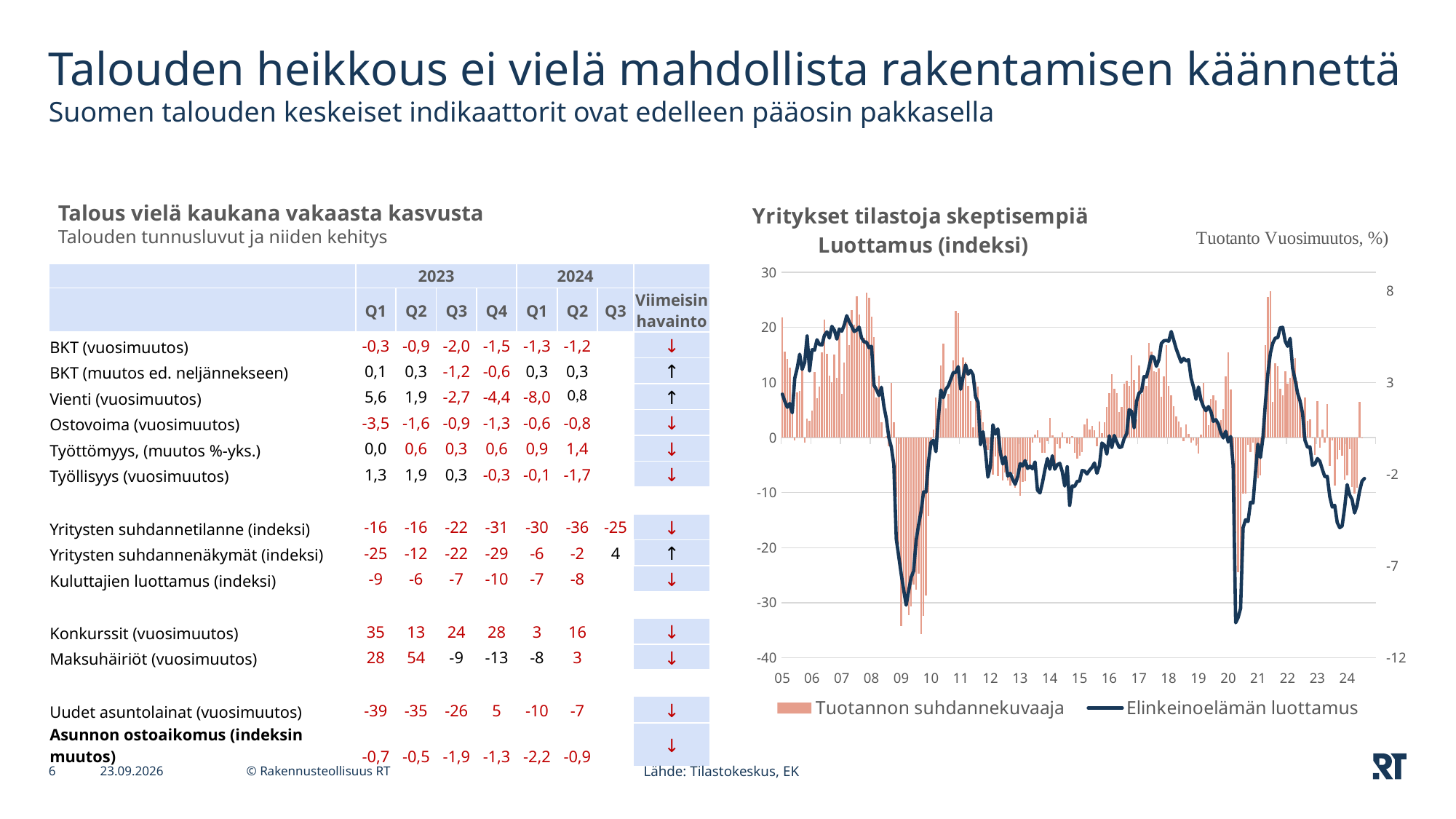
How many series does the legend of the chart "Yritykset tilastoja skeptisempiä" list? 2 In the chart "Yritykset tilastoja skeptisempiä", is the value of Elinkeinoelämän luottamus at the end of 2024 greater or less than 0? less How many year labels are shown on the x axis of the chart "Yritykset tilastoja skeptisempiä"? 20 What kind of chart is shown on the right side of the slide under the title "Yritykset tilastoja skeptisempiä"? A combined bar and line chart In the chart "Yritykset tilastoja skeptisempiä", is the value of Elinkeinoelämän luottamus at its 2021 peak greater or less than 10? greater In the chart "Yritykset tilastoja skeptisempiä", which series is drawn as bars? Tuotannon suhdannekuvaaja In the chart "Yritykset tilastoja skeptisempiä", which series is drawn as a line? Elinkeinoelämän luottamus In the chart "Yritykset tilastoja skeptisempiä", is the value of Elinkeinoelämän luottamus at its 2009 low greater or less than -20? less In the chart "Yritykset tilastoja skeptisempiä", does Elinkeinoelämän luottamus rise or fall from 2022 to 2023? fall In the chart "Yritykset tilastoja skeptisempiä", does Elinkeinoelämän luottamus rise or fall from 2016 to 2018? rise